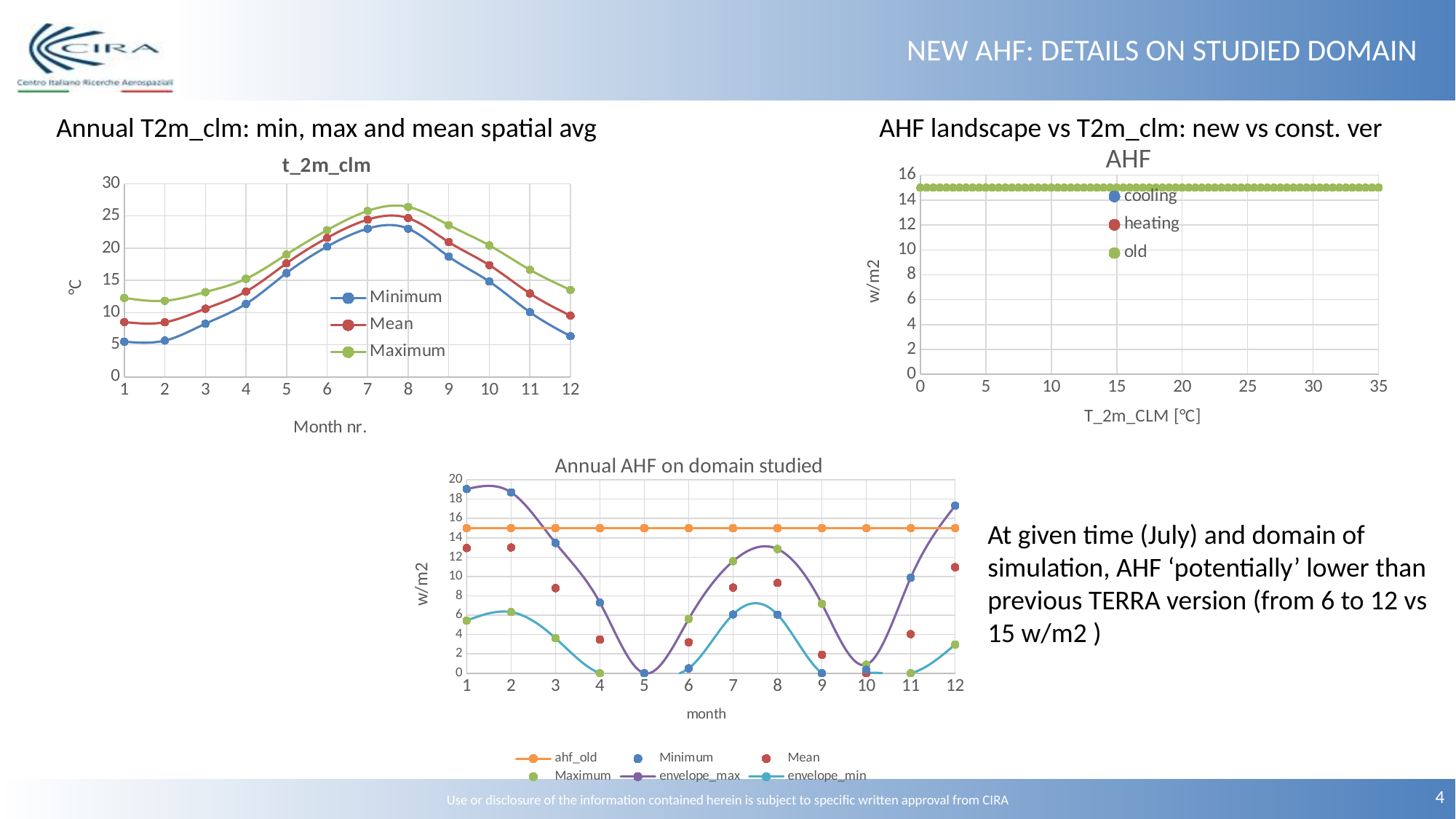
In the Annual AHF on domain studied chart, which is larger at month 1, the Minimum or the Mean value? Minimum What kind of chart is the t_2m_clm chart? line chart In the t_2m_clm chart, how many series does the legend list? 3 In the AHF chart (top right), how many series does the legend list? 3 In the t_2m_clm chart, does the Minimum series rise or fall from month 8 to month 12? fall In the Annual AHF on domain studied chart, how many series does the legend list? 6 In the Annual AHF on domain studied chart, is the Minimum value at month 1 greater or less than 15? greater In the t_2m_clm chart, which is larger at month 6, the Maximum or the Minimum value? Maximum In the AHF chart (top right), what is the label of the x axis? T_2m_CLM [°C] In the t_2m_clm chart, how many months are plotted along the x axis? 12 In the t_2m_clm chart, is the Minimum value at month 1 greater or less than 10? less In the t_2m_clm chart, is the Maximum value at month 8 greater or less than 25? greater